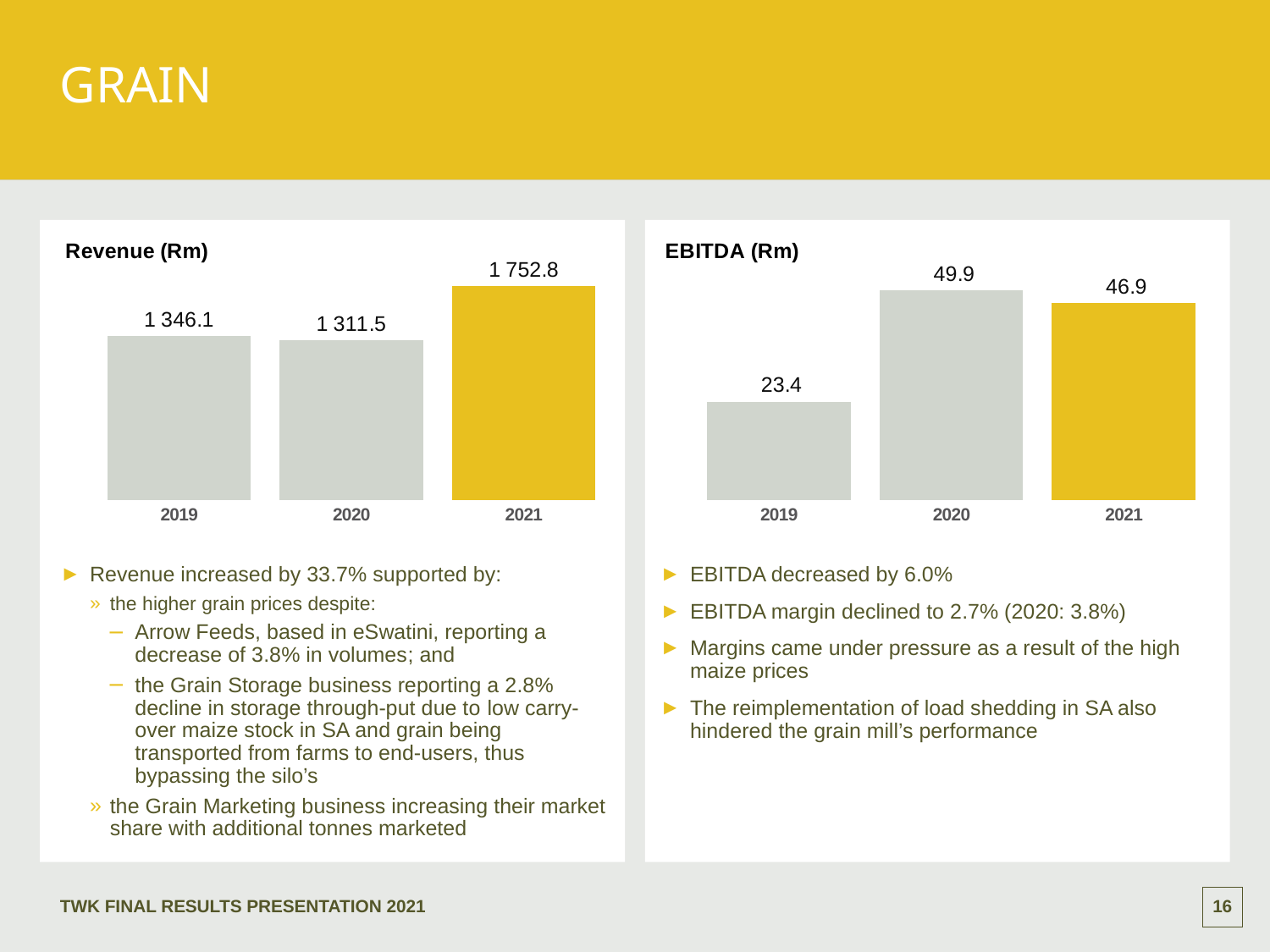
In the Revenue (Rm) chart, which year has the lowest revenue? 2020 In the Revenue (Rm) chart, what is the value for 2021? 1 752.8 In the EBITDA (Rm) chart, what is the value for 2019? 23.4 How many years are shown in the Revenue (Rm) chart? 3 In the EBITDA (Rm) chart, what is the difference between the 2020 and 2021 values? 3.0 In the Revenue (Rm) chart, what is the value for 2019? 1 346.1 In the EBITDA (Rm) chart, which year has the highest EBITDA? 2020 What kind of chart is the EBITDA (Rm) chart? Bar chart In the Revenue (Rm) chart, which year's bar is coloured yellow? 2021 In the Revenue (Rm) chart, what is the difference between the 2021 and 2020 values? 441.3 In the EBITDA (Rm) chart, which is larger, the value for 2019 or the value for 2021? 2021 In the EBITDA (Rm) chart, what is the value for 2020? 49.9